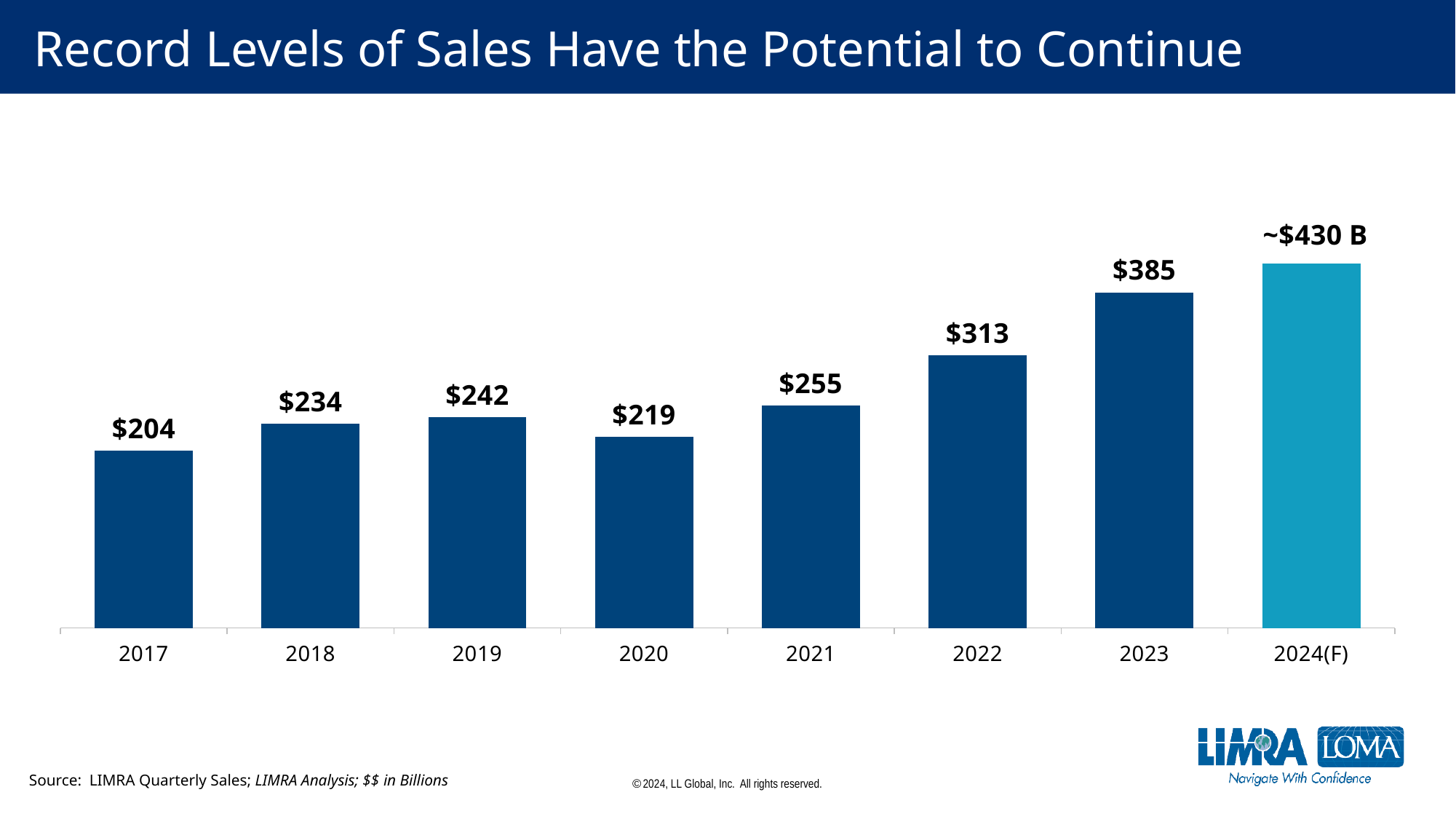
What kind of chart is shown on the slide? Bar chart What is the difference between the values for 2019 and 2020? $23 Which year has the highest value? 2024(F) Which is larger, the value for 2018 or the value for 2020? 2018 What is the title of the slide? Record Levels of Sales Have the Potential to Continue What is the value for 2023? $385 Which year has the lowest value? 2017 What is the label shown for 2024(F)? ~$430 B What is the difference between the values for 2023 and 2022? $72 What is the value for 2020? $219 What is the value for 2017? $204 How many years are shown on the x axis? 8